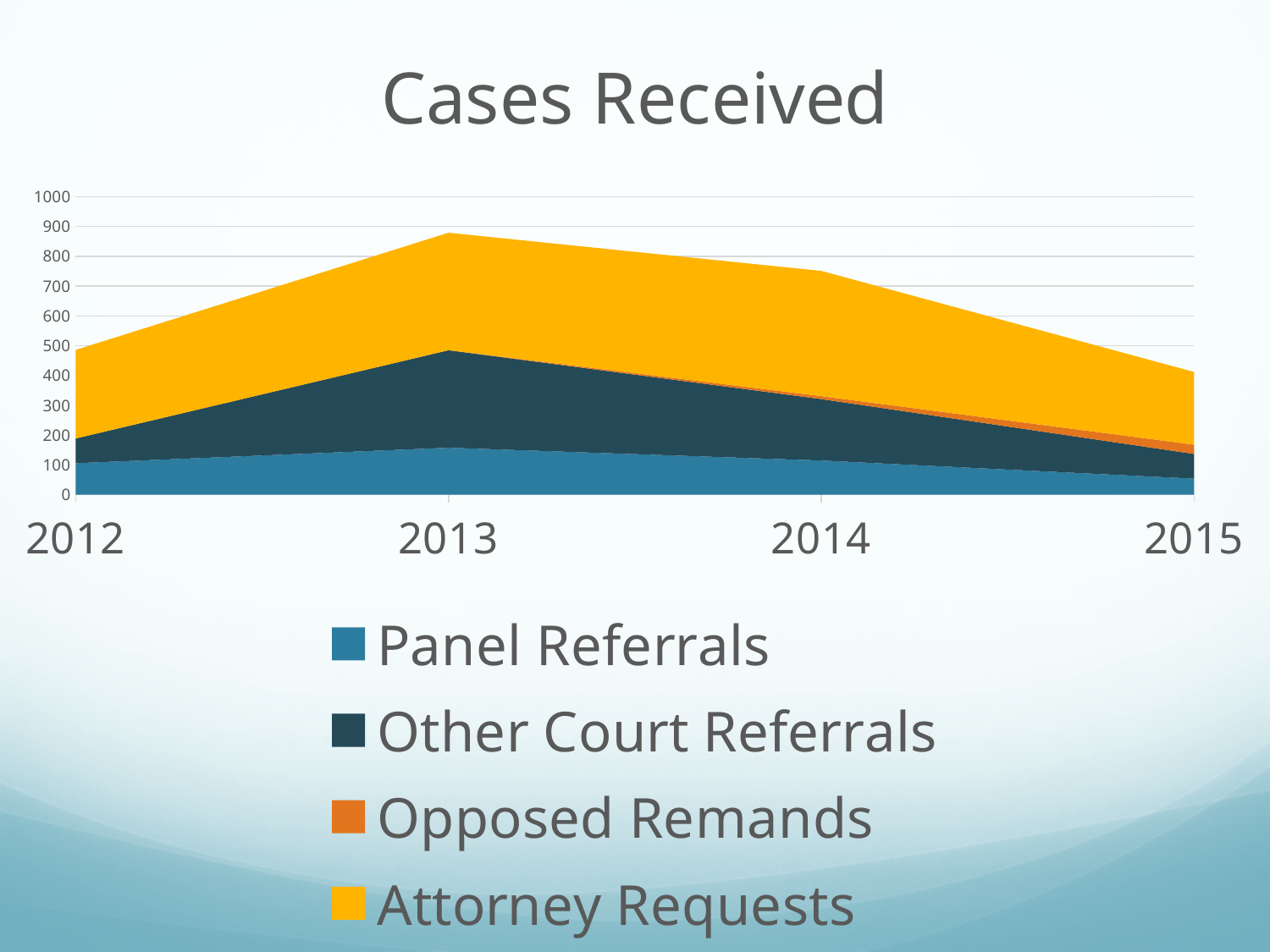
Is the value for Panel Referrals in 2013 greater or less than 100? greater How many years are shown on the x axis? 4 How many series does the legend list? 4 What is the title of the chart? Cases Received Which year has the highest total of cases received? 2013 Which year has the lowest total of cases received? 2015 Is the total of cases received in 2013 greater or less than 800? greater What kind of chart is shown on the slide? Stacked area chart Is the value for Panel Referrals in 2015 greater or less than 100? less Does the total of cases received rise or fall from 2013 to 2015? fall Which series is shown in yellow? Attorney Requests